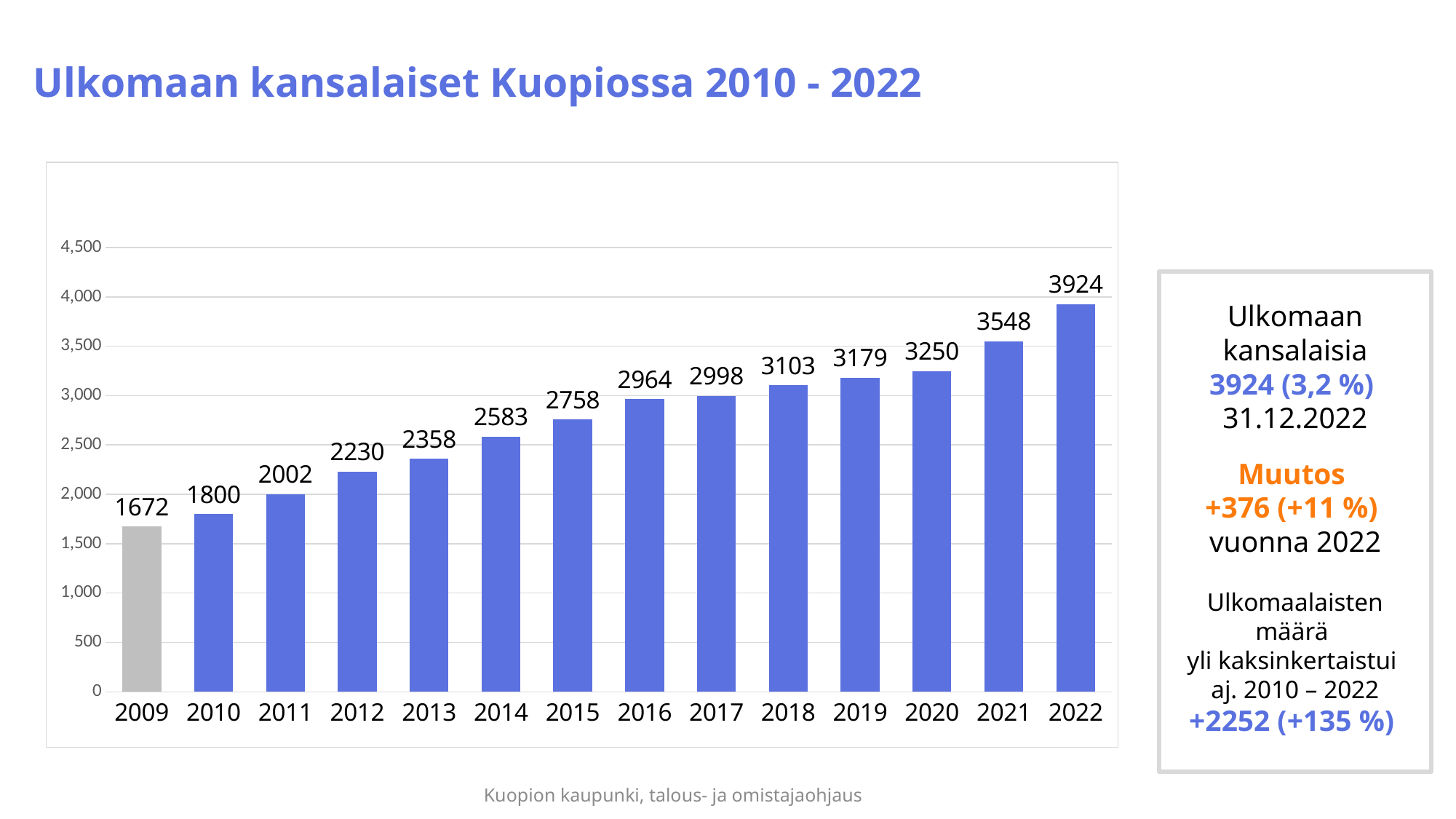
What is the difference between the values for 2022 and 2021? 376 What is the value for 2009? 1672 Do the values rise or fall from 2009 to 2022? rise What is the difference between the values for 2010 and 2022? 2124 What is the value for 2015? 2758 Which is larger, the value for 2013 or the value for 2016? 2016 Is the value for 2018 greater or less than 3,000? greater How many years are shown on the x axis? 14 Which year has the highest value? 2022 What kind of chart is shown on the slide? bar chart What is the value for 2020? 3250 Which year has the lowest value? 2009